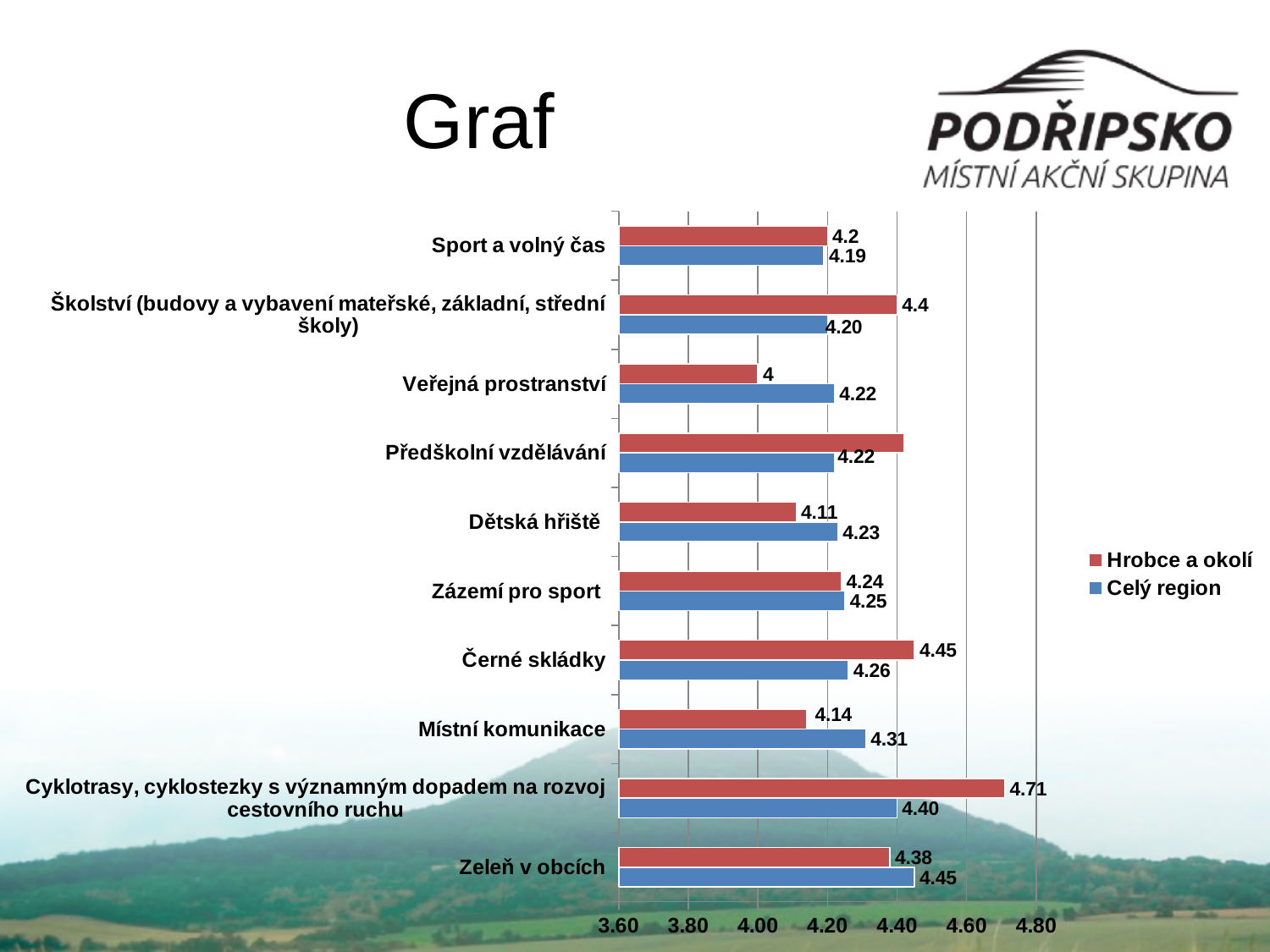
Which category has the highest value for Celý region? Zeleň v obcích What kind of chart is shown on the slide? bar chart What is the difference between the Hrobce a okolí and Celý region values for Černé skládky? 0.19 How many categories are shown on the chart? 10 How many series does the legend list? 2 Is the value for Hrobce a okolí in the Předškolní vzdělávání category greater or less than 4.20? greater What is the value for Hrobce a okolí in the Cyklotrasy, cyklostezky s významným dopadem na rozvoj cestovního ruchu category? 4.71 For Místní komunikace, which series has the larger value, Hrobce a okolí or Celý region? Celý region Which category has the lowest value for Hrobce a okolí? Veřejná prostranství What is the value for Hrobce a okolí in the Veřejná prostranství category? 4 Which category has the highest value for Hrobce a okolí? Cyklotrasy, cyklostezky s významným dopadem na rozvoj cestovního ruchu What is the value for Celý region in the Místní komunikace category? 4.31